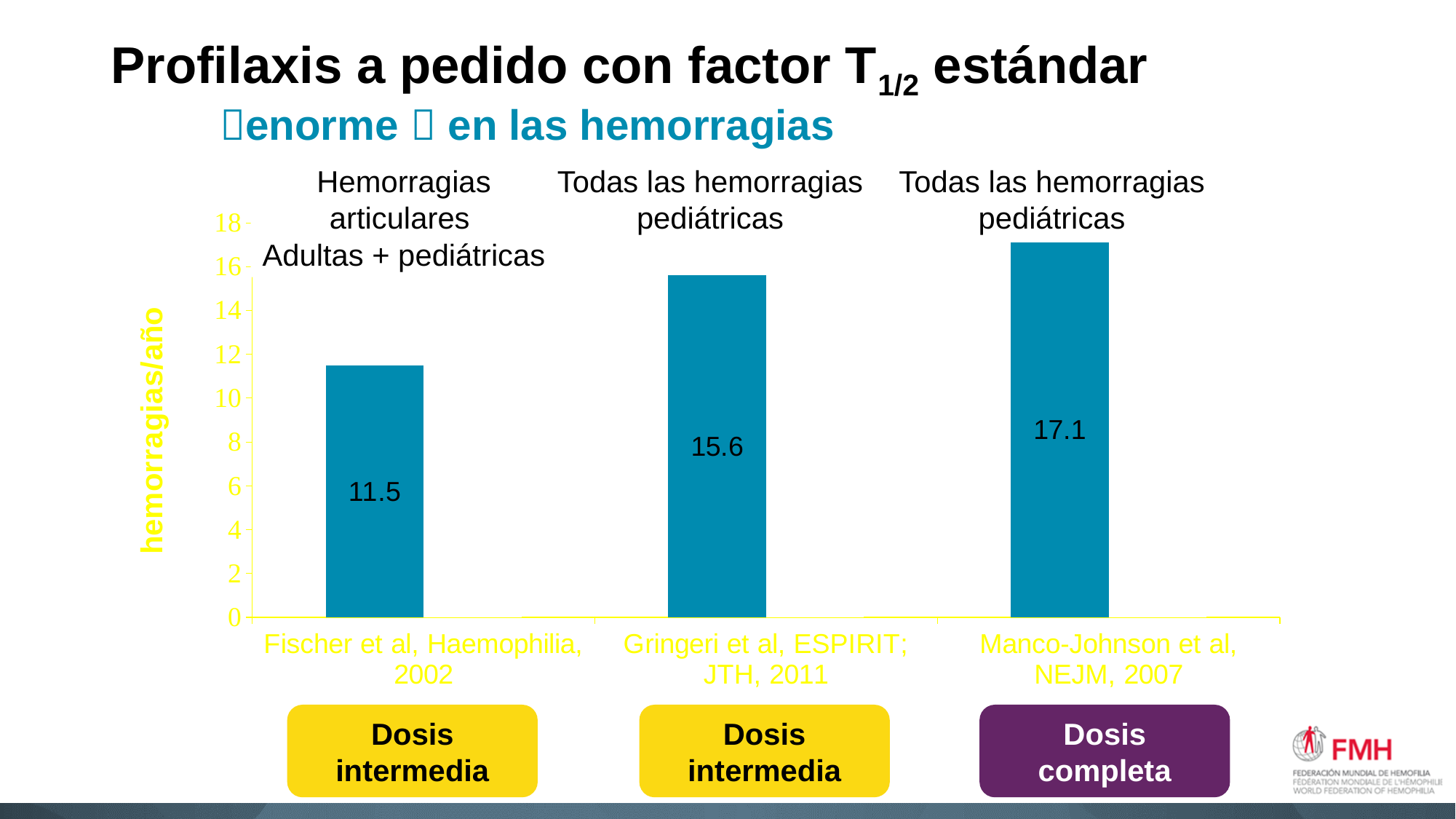
Which is larger, the value for Gringeri et al, ESPIRIT; JTH, 2011 or the value for Manco-Johnson et al, NEJM, 2007? Manco-Johnson et al, NEJM, 2007 How many bars are shown in the chart? 3 What is the value for Gringeri et al, ESPIRIT; JTH, 2011? 15.6 What kind of chart is shown on the slide? bar chart Which study has the highest number of hemorragias/año? Manco-Johnson et al, NEJM, 2007 What is the difference between the values for Gringeri et al, ESPIRIT; JTH, 2011 and Fischer et al, Haemophilia, 2002? 4.1 What is the value for Manco-Johnson et al, NEJM, 2007? 17.1 What is the value for Fischer et al, Haemophilia, 2002? 11.5 Is the value for Fischer et al, Haemophilia, 2002 greater or less than 12? less What is the difference between the values for Manco-Johnson et al, NEJM, 2007 and Fischer et al, Haemophilia, 2002? 5.6 Which study has the lowest number of hemorragias/año? Fischer et al, Haemophilia, 2002 What is the label of the y axis? hemorragias/año